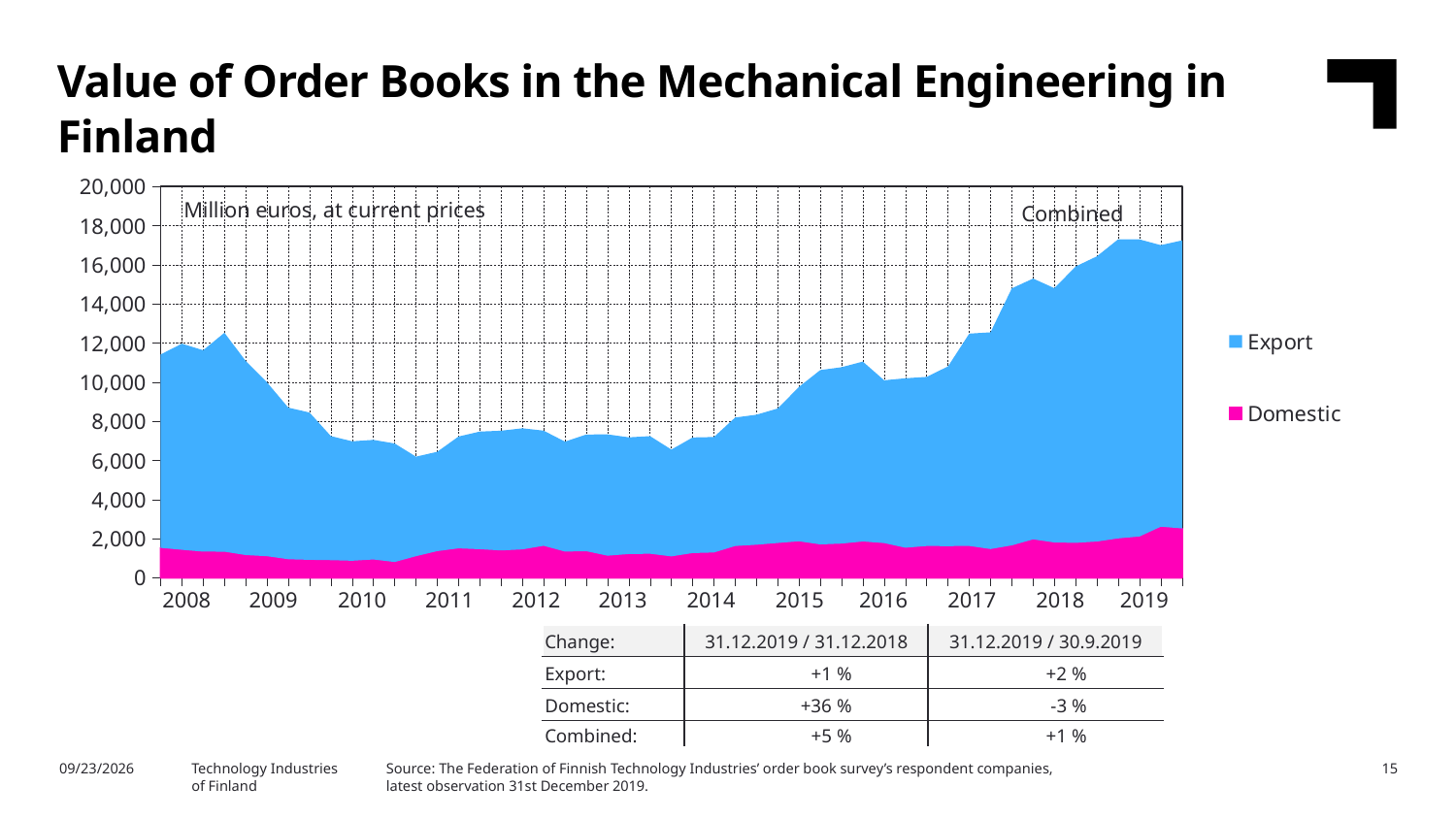
Is the Domestic value at the end of 2019 greater or less than 4,000? less How many series does the legend list? 2 Is the combined value of order books at the start of 2008 greater or less than 10,000? greater Does the combined value of order books rise or fall from 2017 to 2019? rise Is the combined value of order books at the start of 2014 greater or less than 8,000? less Which series is larger throughout the period, Export or Domestic? Export What unit is stated in the label inside the chart area? Million euros, at current prices Does the combined value of order books rise or fall from 2008 to 2010? fall What kind of chart is shown on the slide? Stacked area chart Which two series are listed in the chart legend? Export and Domestic How many years are labelled on the x axis? 12